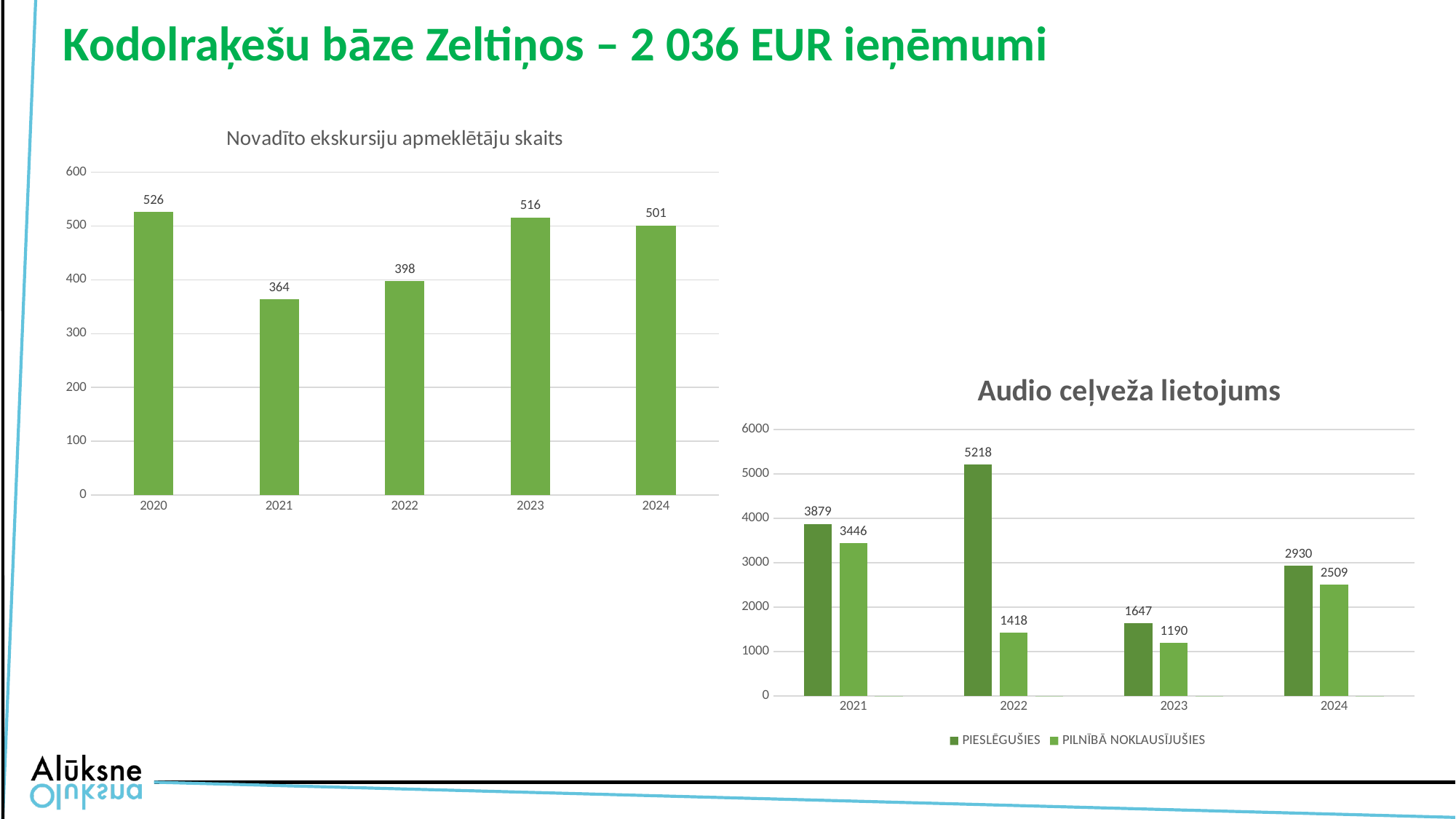
In the chart 'Audio ceļveža lietojums', what is the value for PILNĪBĀ NOKLAUSĪJUŠIES in 2023? 1190 In the chart 'Audio ceļveža lietojums', how many series does the legend list? 2 What kind of chart is 'Novadīto ekskursiju apmeklētāju skaits'? Bar chart In the chart 'Novadīto ekskursiju apmeklētāju skaits', what is the difference between the values for 2023 and 2022? 118 In the chart 'Novadīto ekskursiju apmeklētāju skaits', which year has the highest value? 2020 In the chart 'Audio ceļveža lietojums', which is larger in 2021: PIESLĒGUŠIES or PILNĪBĀ NOKLAUSĪJUŠIES? PIESLĒGUŠIES In the chart 'Novadīto ekskursiju apmeklētāju skaits', which year has the lowest value? 2021 In the chart 'Novadīto ekskursiju apmeklētāju skaits', how many years are shown on the x axis? 5 In the chart 'Novadīto ekskursiju apmeklētāju skaits', what is the value for 2020? 526 In the chart 'Audio ceļveža lietojums', which year has the highest PIESLĒGUŠIES value? 2022 In the chart 'Audio ceļveža lietojums', what is the difference between PIESLĒGUŠIES and PILNĪBĀ NOKLAUSĪJUŠIES in 2024? 421 In the chart 'Audio ceļveža lietojums', what is the value for PIESLĒGUŠIES in 2022? 5218